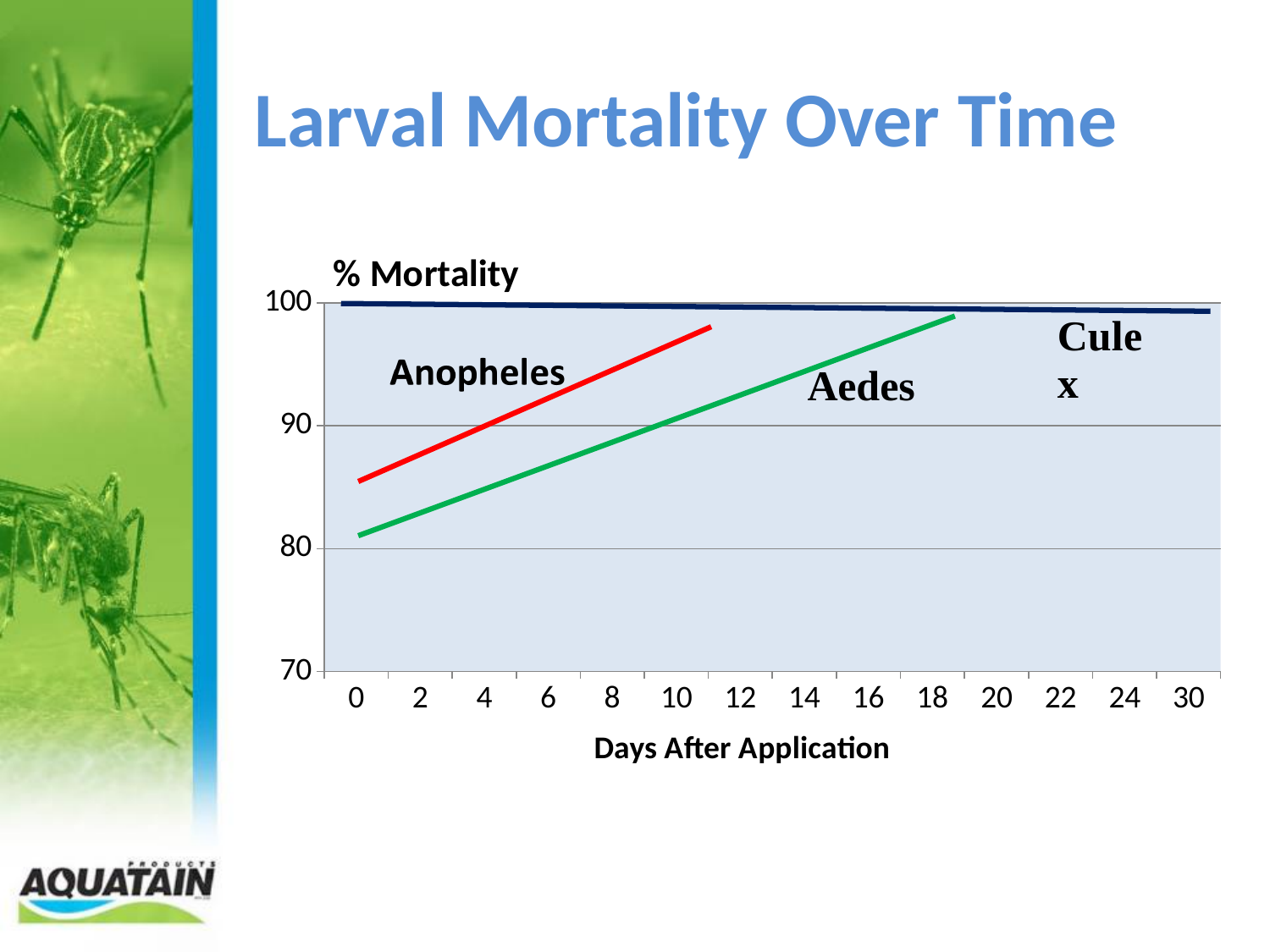
Is the % mortality for Culex at day 0 greater or less than 90? greater What is the label of the x axis? Days After Application Which species has the lowest % mortality at day 0? Aedes Is the % mortality for Aedes at day 0 greater or less than 90? less Which species has the highest % mortality at day 0? Culex Does the Aedes line rise or fall as days after application increase? rise What is the title of the chart on the slide? % Mortality How many species lines are plotted on the chart? 3 Does the Anopheles line rise or fall as days after application increase? rise What kind of chart is shown on the slide? line chart Is the % mortality for Anopheles at day 0 greater or less than 90? less At day 0, is the % mortality for Anopheles or Aedes larger? Anopheles